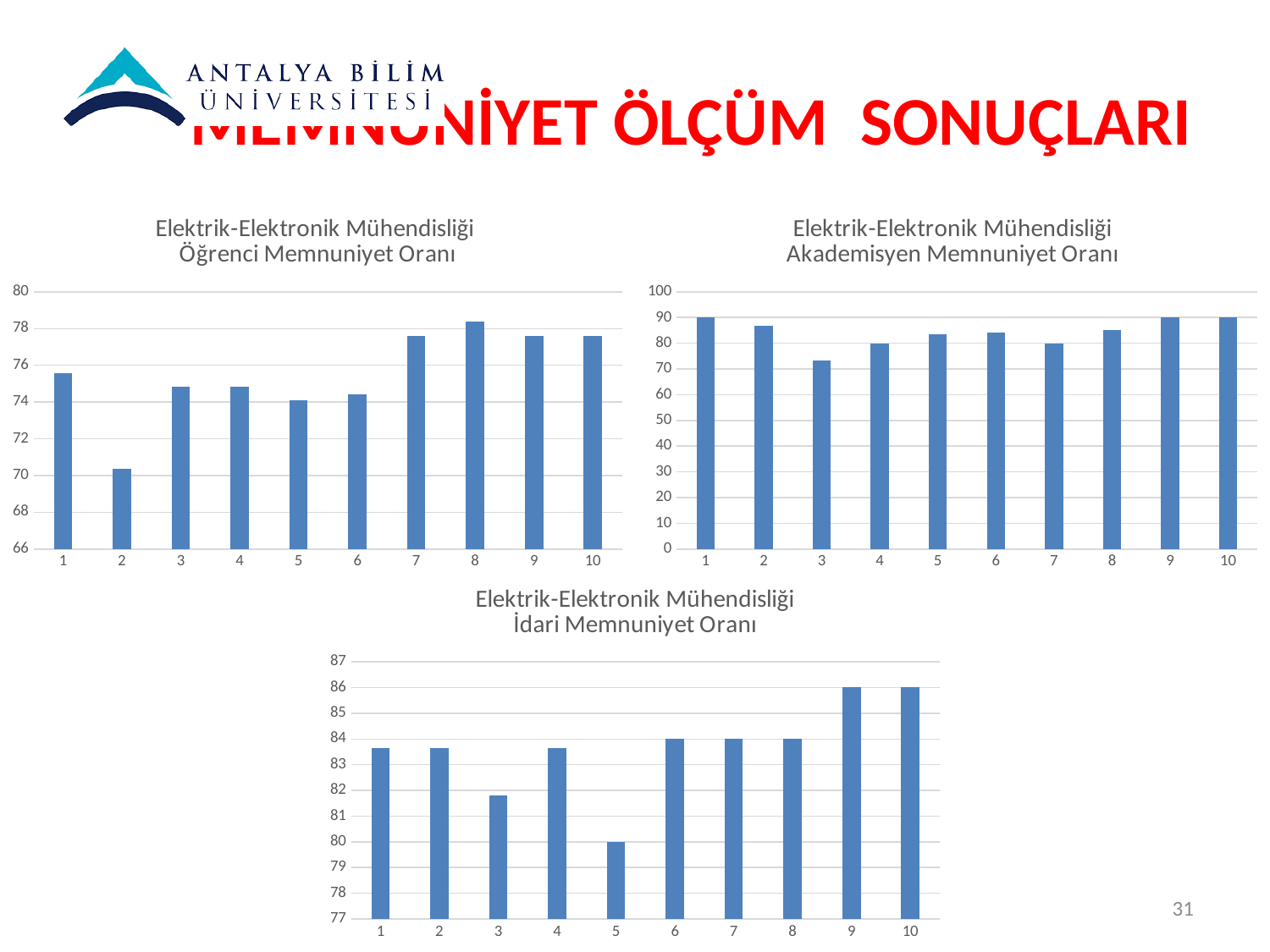
In the chart titled 'Elektrik-Elektronik Mühendisliği Akademisyen Memnuniyet Oranı', which category has the lowest value? 3 In the chart titled 'Elektrik-Elektronik Mühendisliği İdari Memnuniyet Oranı', which category has the lowest value? 5 In the chart titled 'Elektrik-Elektronik Mühendisliği Öğrenci Memnuniyet Oranı', how many categories are plotted on the x axis? 10 In the chart titled 'Elektrik-Elektronik Mühendisliği Öğrenci Memnuniyet Oranı', is the value for category 8 greater or less than 78? greater In the chart titled 'Elektrik-Elektronik Mühendisliği Öğrenci Memnuniyet Oranı', is the value for category 2 greater or less than 72? less In the chart titled 'Elektrik-Elektronik Mühendisliği İdari Memnuniyet Oranı', is the value for category 9 greater or less than 85? greater In the chart titled 'Elektrik-Elektronik Mühendisliği Akademisyen Memnuniyet Oranı', which has the larger value, category 2 or category 3? 2 In the chart titled 'Elektrik-Elektronik Mühendisliği Öğrenci Memnuniyet Oranı', which category has the highest value? 8 In the chart titled 'Elektrik-Elektronik Mühendisliği Öğrenci Memnuniyet Oranı', which category has the lowest value? 2 In the chart titled 'Elektrik-Elektronik Mühendisliği Öğrenci Memnuniyet Oranı', what kind of chart is shown? bar chart In the chart titled 'Elektrik-Elektronik Mühendisliği İdari Memnuniyet Oranı', which has the larger value, category 3 or category 6? 6